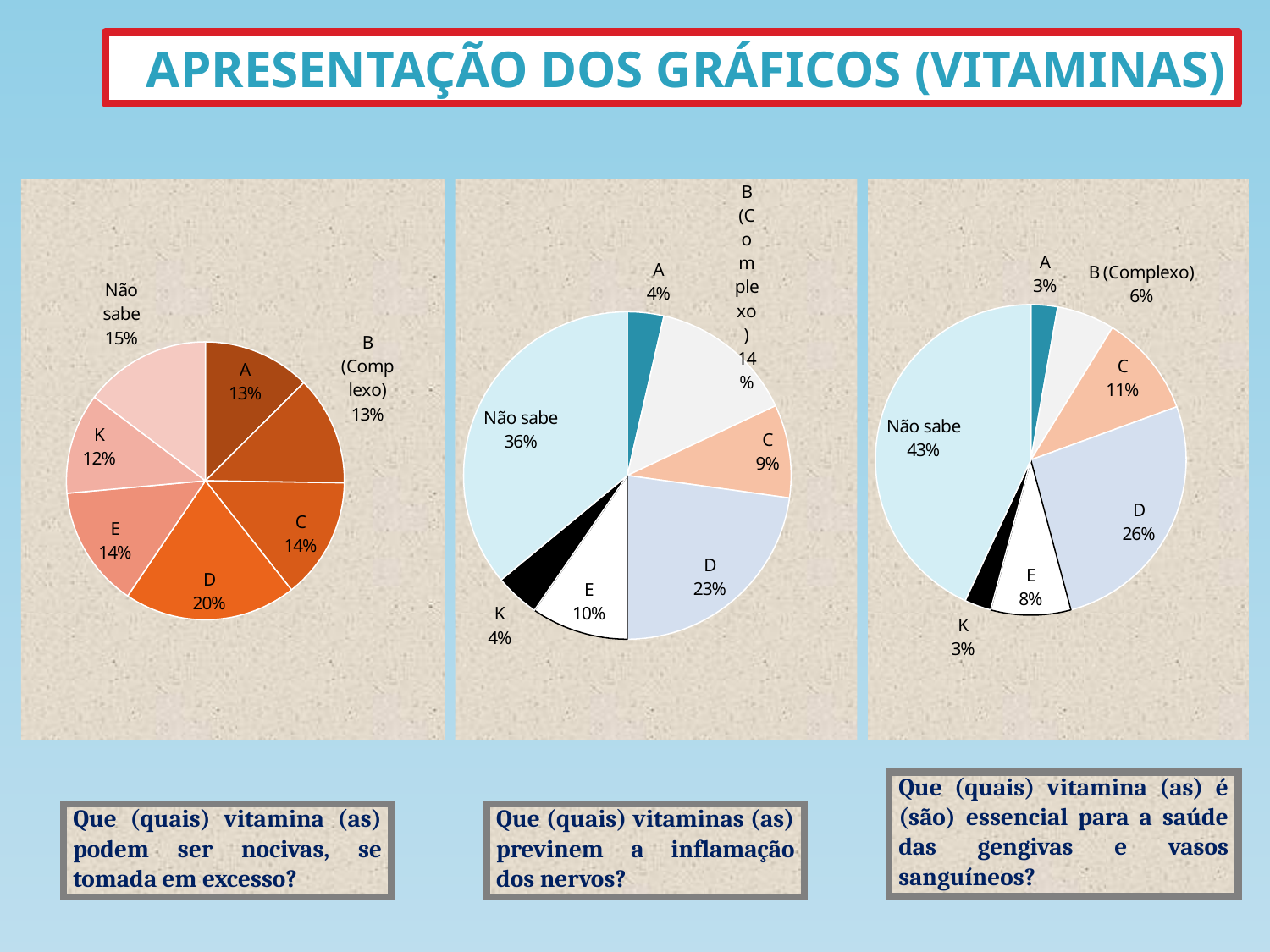
In the left pie chart, which category has the smallest share? K In the middle pie chart, what share is labelled for Não sabe? 36% In the right pie chart, which category has the largest share? Não sabe What kind of chart is the left chart? Pie chart In the middle pie chart, which is larger, the share for B (Complexo) or the share for E? B (Complexo) In the middle pie chart, what is the difference between the shares for D and C? 14% In the right pie chart, what share is labelled for C? 11% In the middle pie chart, which category has the largest share? Não sabe In the right pie chart, what is the difference between the shares for Não sabe and D? 17% In the right pie chart, what share is labelled for D? 26% In the left pie chart, what share is labelled for D? 20% In the left pie chart, how many slices does the pie have? 7